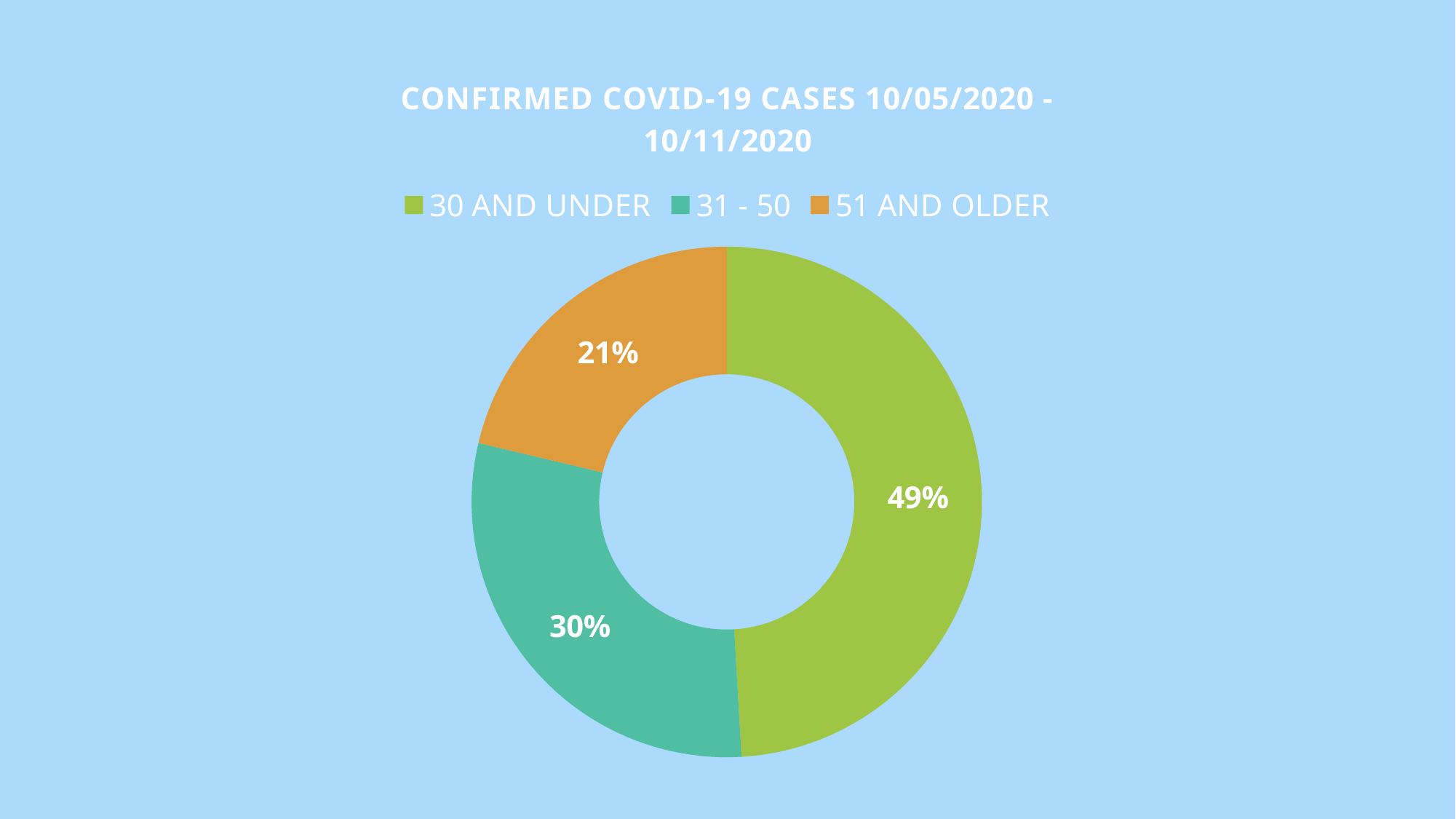
Which age group has the smallest share of confirmed cases? 51 AND OLDER Which age group has the largest share of confirmed cases? 30 AND UNDER What share of confirmed cases is for the 51 AND OLDER group? 21% What kind of chart is shown on the slide? Pie chart (doughnut) What is the title of the chart? CONFIRMED COVID-19 CASES 10/05/2020 - 10/11/2020 What is the difference in percentage points between the 31 - 50 share and the 51 AND OLDER share? 9 What share of confirmed cases is for the 31 - 50 group? 30% What colour represents the 51 AND OLDER group? Orange What is the difference in percentage points between the 30 AND UNDER share and the 51 AND OLDER share? 28 Which group has a larger share, 31 - 50 or 51 AND OLDER? 31 - 50 How many age groups are shown in the chart? 3 What share of confirmed cases is for the 30 AND UNDER group? 49%